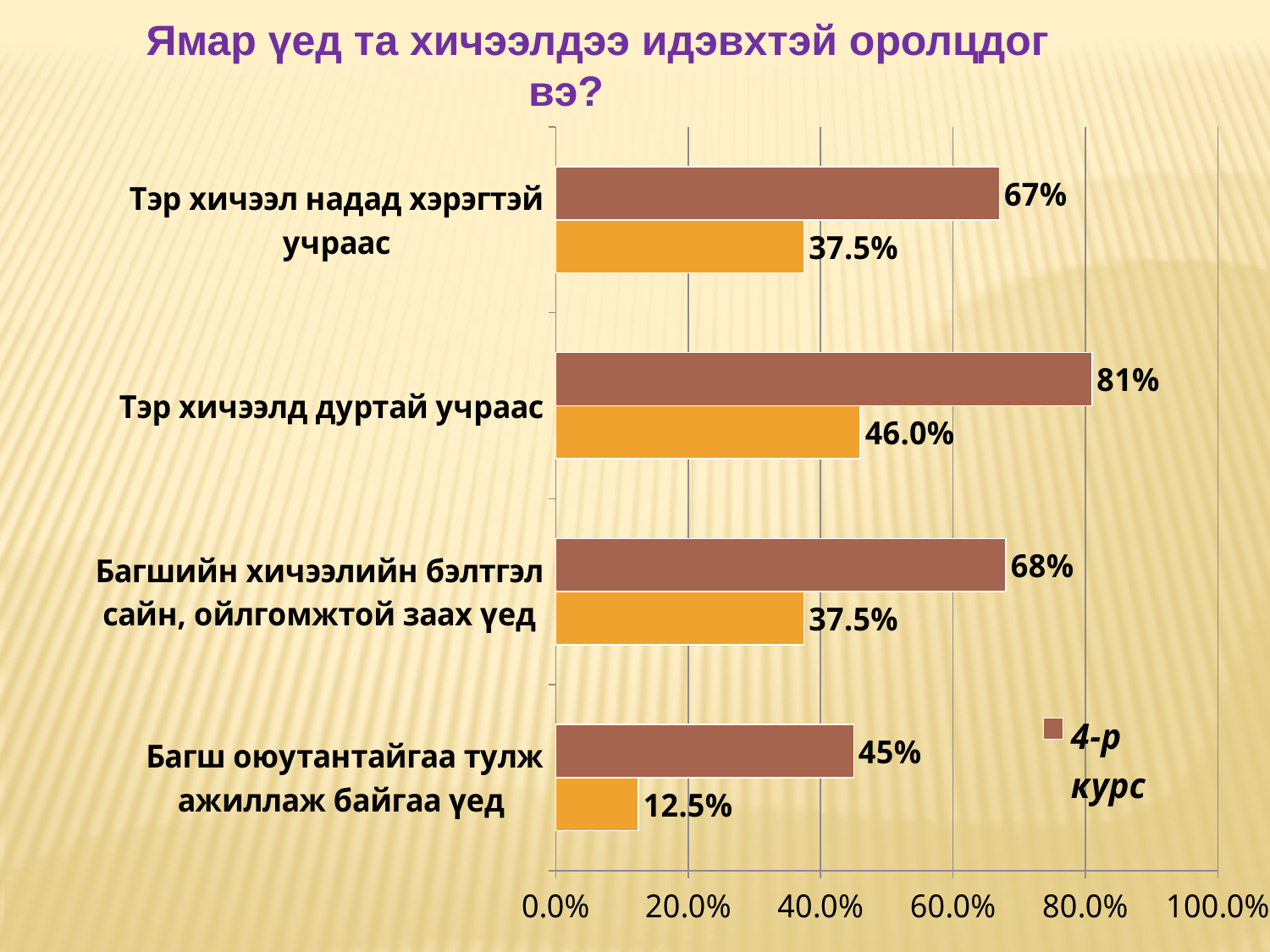
What is the difference between the 4-р курс value and the orange-bar value for "Тэр хичээлд дуртай учраас"? 35% What kind of chart is shown on the slide? Bar chart Which category has the highest 4-р курс value? Тэр хичээлд дуртай учраас What is the value of the orange bar for "Багш оюутантайгаа тулж ажиллаж байгаа үед"? 12.5% What is the value of the 4-р курс bar for "Багшийн хичээлийн бэлтгэл сайн, ойлгомжтой заах үед"? 68% Which category has the lowest orange-bar value? Багш оюутантайгаа тулж ажиллаж байгаа үед What is the value of the 4-р курс bar for "Тэр хичээлд дуртай учраас"? 81% How many categories are shown on the chart? 4 What is the value of the orange bar for "Тэр хичээлд дуртай учраас"? 46.0% Which is larger: the 4-р курс value for "Тэр хичээл надад хэрэгтэй учраас" or for "Багшийн хичээлийн бэлтгэл сайн, ойлгомжтой заах үед"? Багшийн хичээлийн бэлтгэл сайн, ойлгомжтой заах үед What series name is shown in the chart legend? 4-р курс Is the 4-р курс value for "Багш оюутантайгаа тулж ажиллаж байгаа үед" greater or less than 60.0%? less